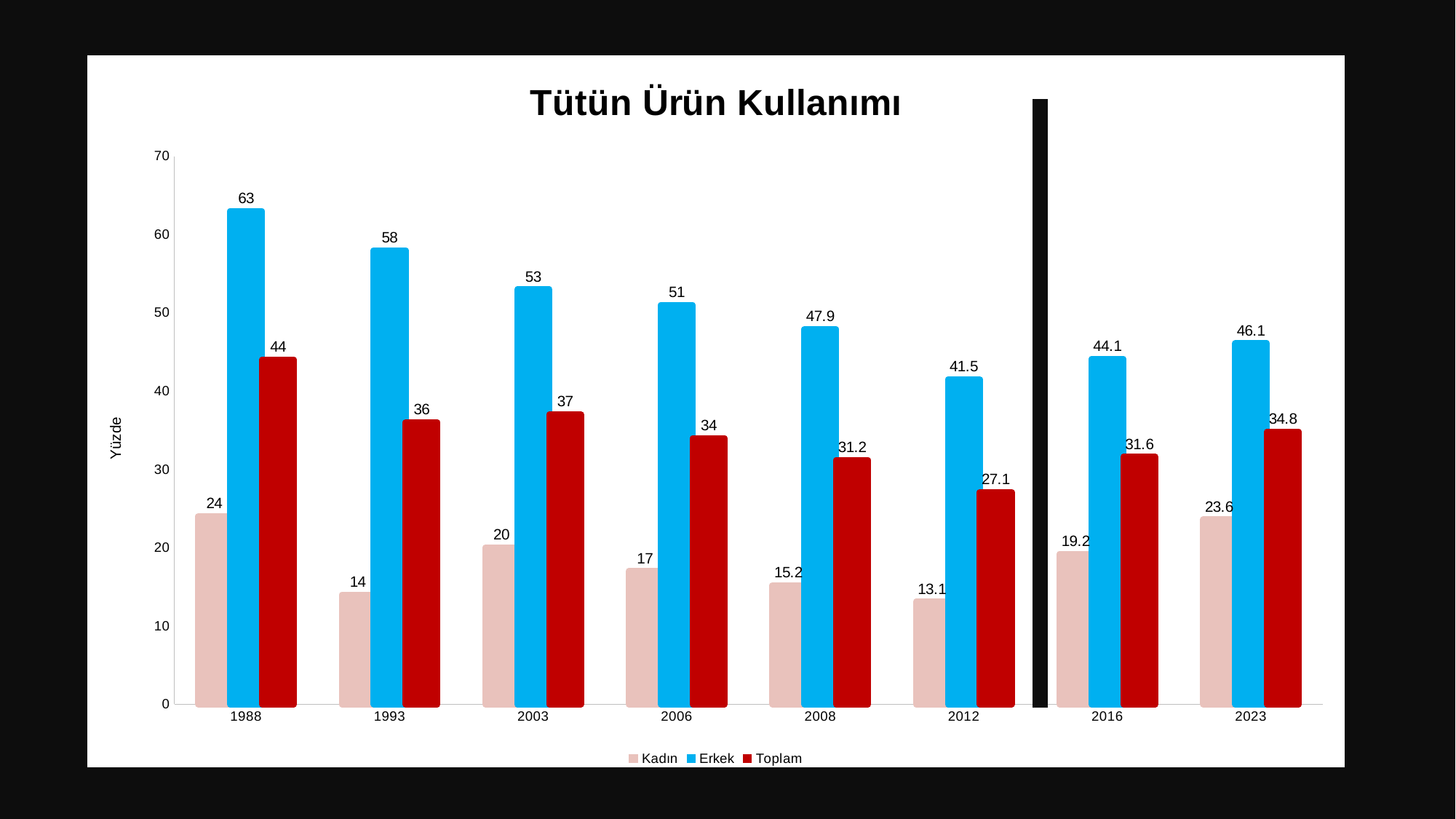
What is the Toplam value for 2023? 34.8 Which is larger, the Toplam value for 2016 or for 2023? 2023 What is the difference between the Erkek and Kadın values in 2006? 34 Is the Erkek value for 2008 greater or less than 40? greater What is the title of the chart? Tütün Ürün Kullanımı How many years are shown on the x axis? 8 What is the Erkek value for 1988? 63 How many series does the legend list? 3 What is the Kadın value for 2012? 13.1 Which year has the highest Erkek value? 1988 Which year has the lowest Kadın value? 2012 What kind of chart is shown? bar chart